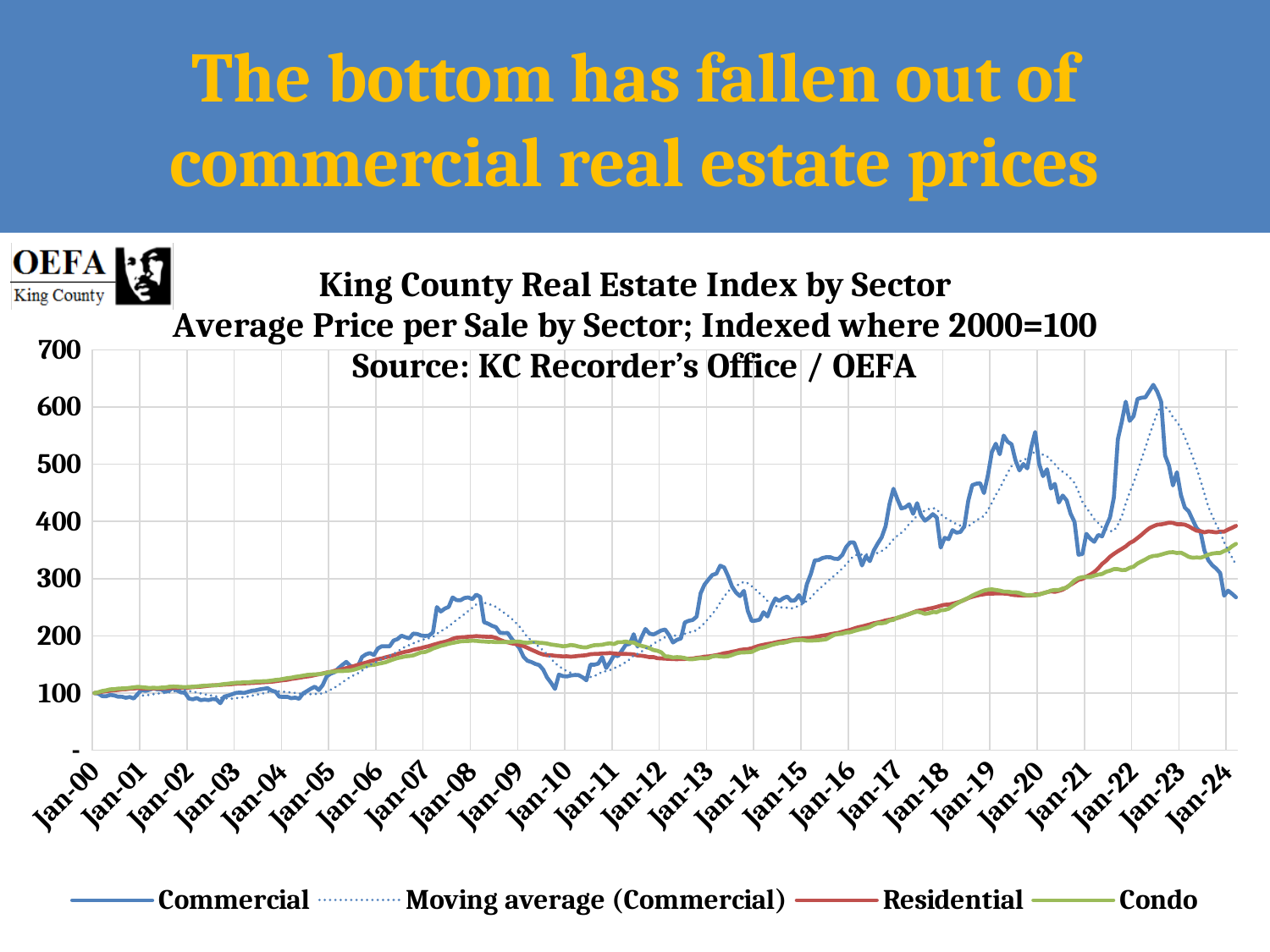
At Jan-24, which is larger, the Residential value or the Commercial value? Residential How many series does the legend list? 4 Is the value for Condo at Jan-24 greater or less than 300? greater At Jan-22, which is larger, the Commercial value or the Condo value? Commercial Which series is drawn as a dotted line? Moving average (Commercial) Is the value for Commercial at Jan-10 greater or less than 200? less Does the Residential line generally rise or fall from Jan-00 to Jan-24? Rise Which series reaches the highest value anywhere on the chart? Commercial Is the value for Residential at Jan-16 greater or less than 300? less What colour is the Condo line? Green What kind of chart is shown on the slide? Line chart